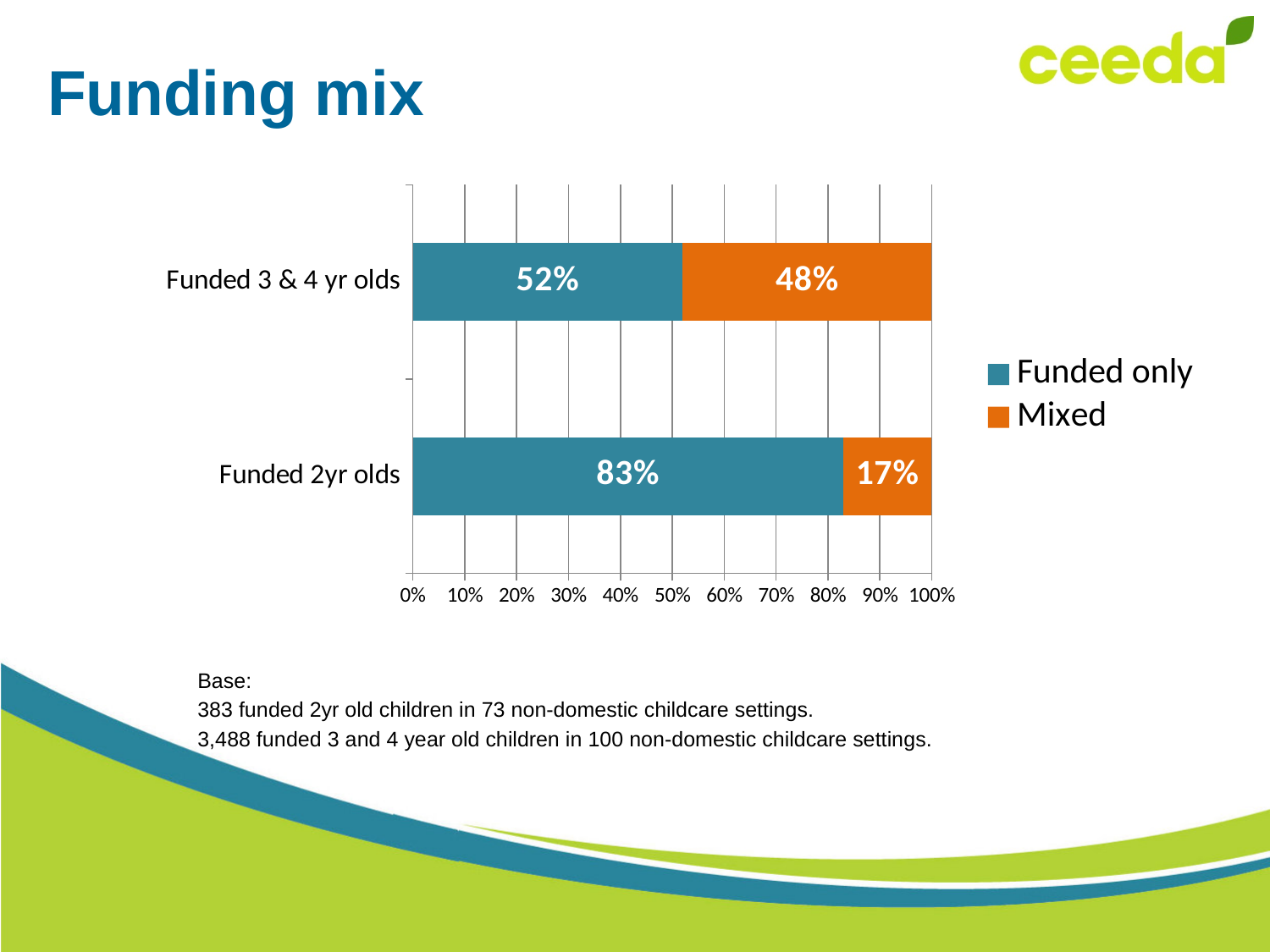
How many series does the legend list? 2 Is the Mixed value for Funded 3 & 4 yr olds larger or smaller than the Mixed value for Funded 2yr olds? larger What is the difference between the Funded only values for Funded 2yr olds and Funded 3 & 4 yr olds? 31% What is the total of the stacked bar for Funded 2yr olds? 100% What is the Funded only value for Funded 3 & 4 yr olds? 52% Which category has the higher Funded only share? Funded 2yr olds What kind of chart is shown on the slide? Stacked bar chart How many categories are shown on the chart? 2 What is the Mixed value for Funded 2yr olds? 17% What is the Funded only value for Funded 2yr olds? 83% What is the Mixed value for Funded 3 & 4 yr olds? 48% Which category has the lower Mixed share? Funded 2yr olds